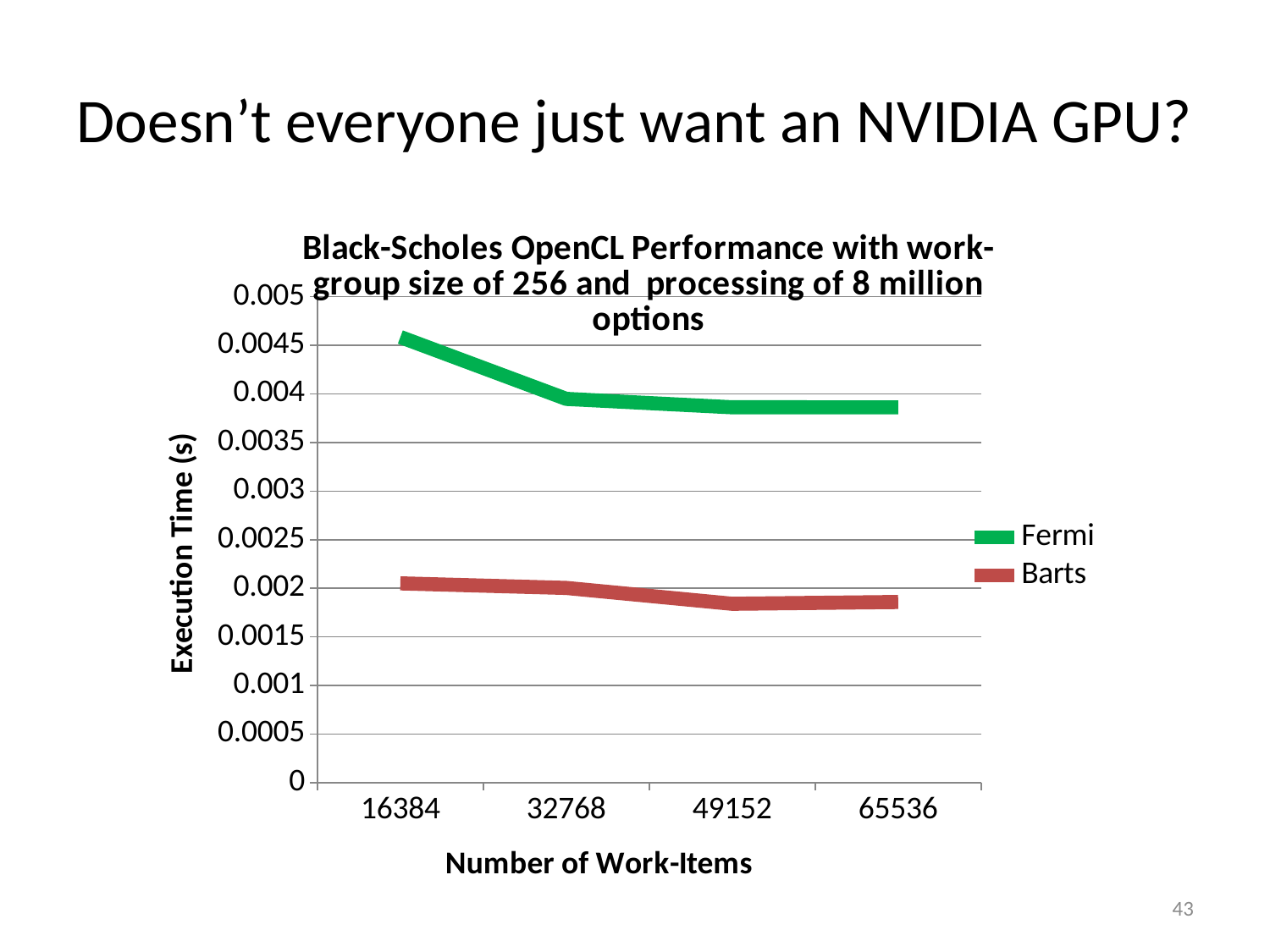
Is the Fermi execution time at 16384 work-items greater or less than 0.004? greater Is the Barts execution time at 16384 work-items greater or less than 0.0015? greater How many work-item counts are plotted along the x axis? 4 What kind of chart is shown on the slide? Line chart What is the label of the y axis? Execution Time (s) Does the Fermi execution time rise or fall as the number of work-items increases? Fall At which number of work-items is the Fermi execution time highest? 16384 Which series are listed in the legend? Fermi and Barts Is the Fermi execution time at 65536 work-items greater or less than 0.004? less At 32768 work-items, which series has the higher execution time, Fermi or Barts? Fermi How many series does the legend list? 2